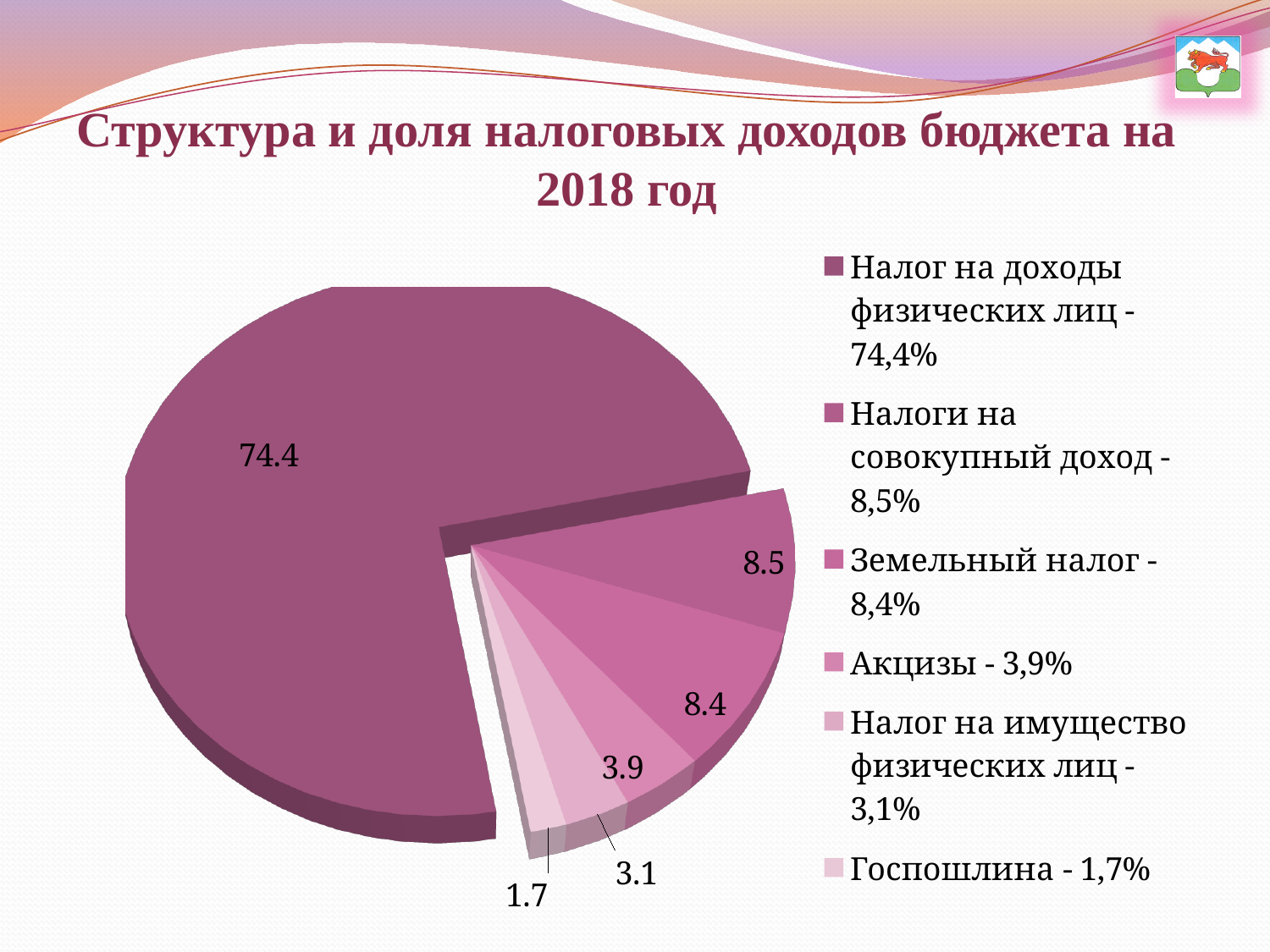
What is the value shown for Госпошлина? 1.7 What is the difference between the values for Налог на доходы физических лиц and Налоги на совокупный доход? 65.9 How many slices does the pie chart have? 6 What is the value shown for Налог на доходы физических лиц? 74.4 Which category has the smallest slice of the pie? Госпошлина What is the value shown for Акцизы? 3.9 What is the value shown for Налоги на совокупный доход? 8.5 What is the value shown for Земельный налог? 8.4 Which category has the largest slice of the pie? Налог на доходы физических лиц Which is larger, the value for Акцизы or the value for Госпошлина? Акцизы What type of chart is shown on the slide? Pie chart What is the value shown for Налог на имущество физических лиц? 3.1